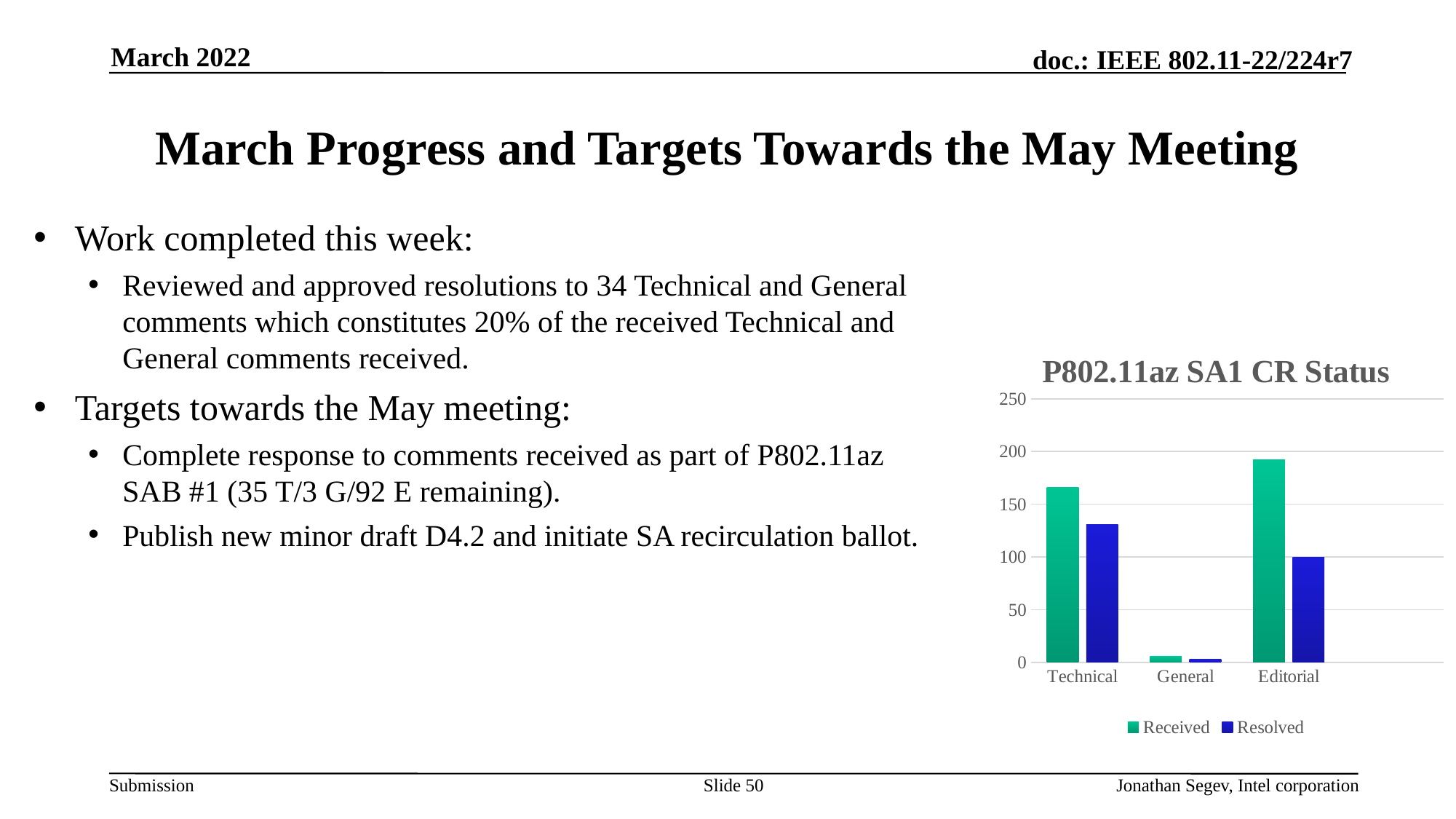
Which is larger, the Resolved value for Technical or the Resolved value for Editorial? Technical Is the Received value for Technical greater or less than 150? greater Which category has the lowest Received value? General What is the title of the chart? P802.11az SA1 CR Status How many series does the chart legend list? 2 Is the Resolved value for Technical greater or less than 150? less Which category has the lowest Resolved value? General Which is larger, the Received value for Technical or the Received value for Editorial? Editorial Is the Received value for Editorial greater or less than 200? less Which category has the highest Received value? Editorial What type of chart is shown on the slide? bar chart How many categories are shown on the x axis of the chart? 3